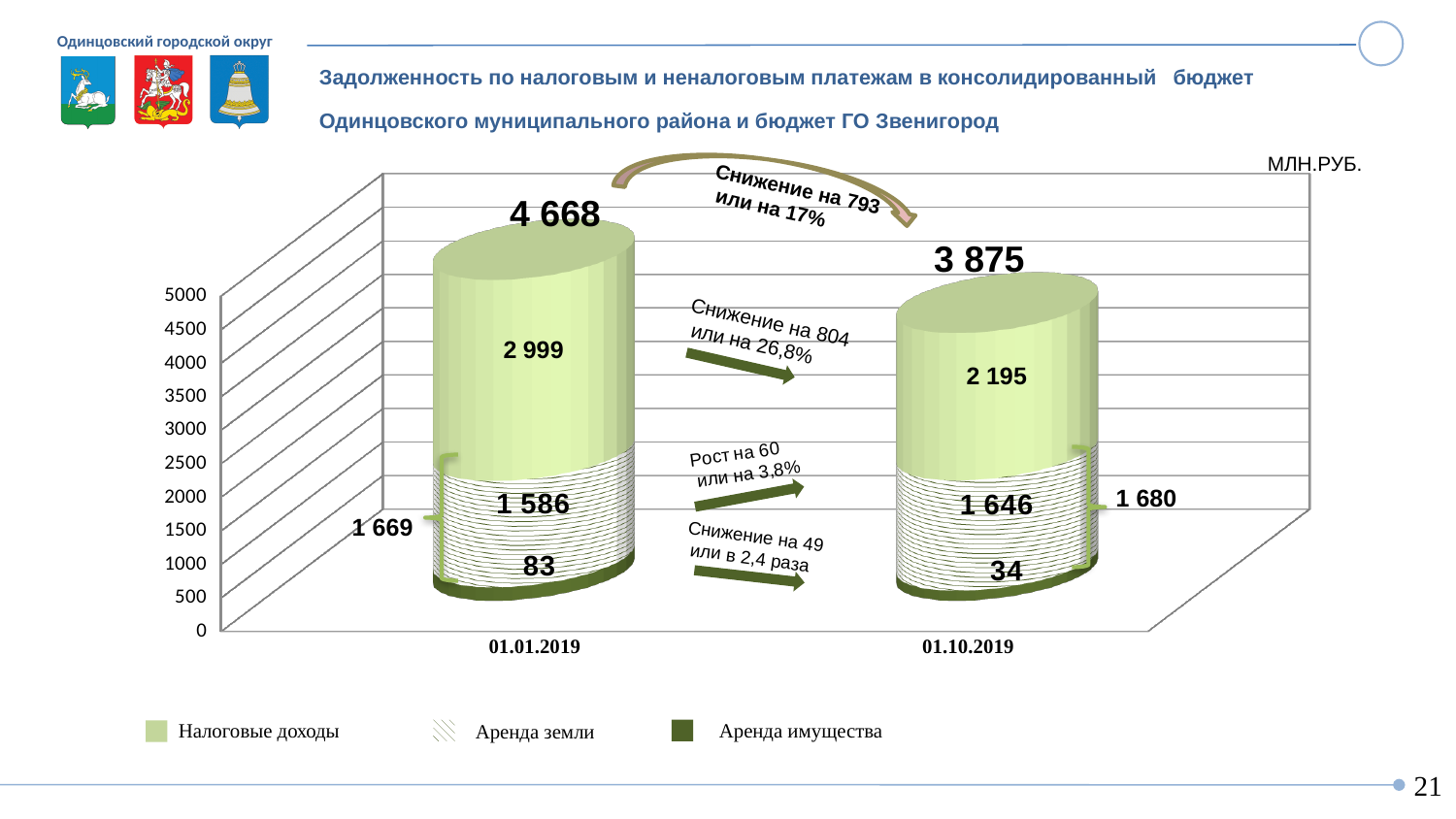
What is the value of Налоговые доходы for 01.01.2019? 2 999 What kind of chart is shown on the slide? Stacked bar chart What is the difference between the Налоговые доходы values for 01.01.2019 and 01.10.2019? 804 Which date has the higher value for Аренда имущества, 01.01.2019 or 01.10.2019? 01.01.2019 What unit is indicated for the values on the chart? МЛН.РУБ. How many categories are shown on the x axis? 2 What is the value of Налоговые доходы for 01.10.2019? 2 195 What is the total of the stacked bar for 01.10.2019? 3 875 How many series does the legend list? 3 What is the value of Аренда земли for 01.10.2019? 1 646 What is the total of the stacked bar for 01.01.2019? 4 668 What is the value of Аренда имущества for 01.01.2019? 83